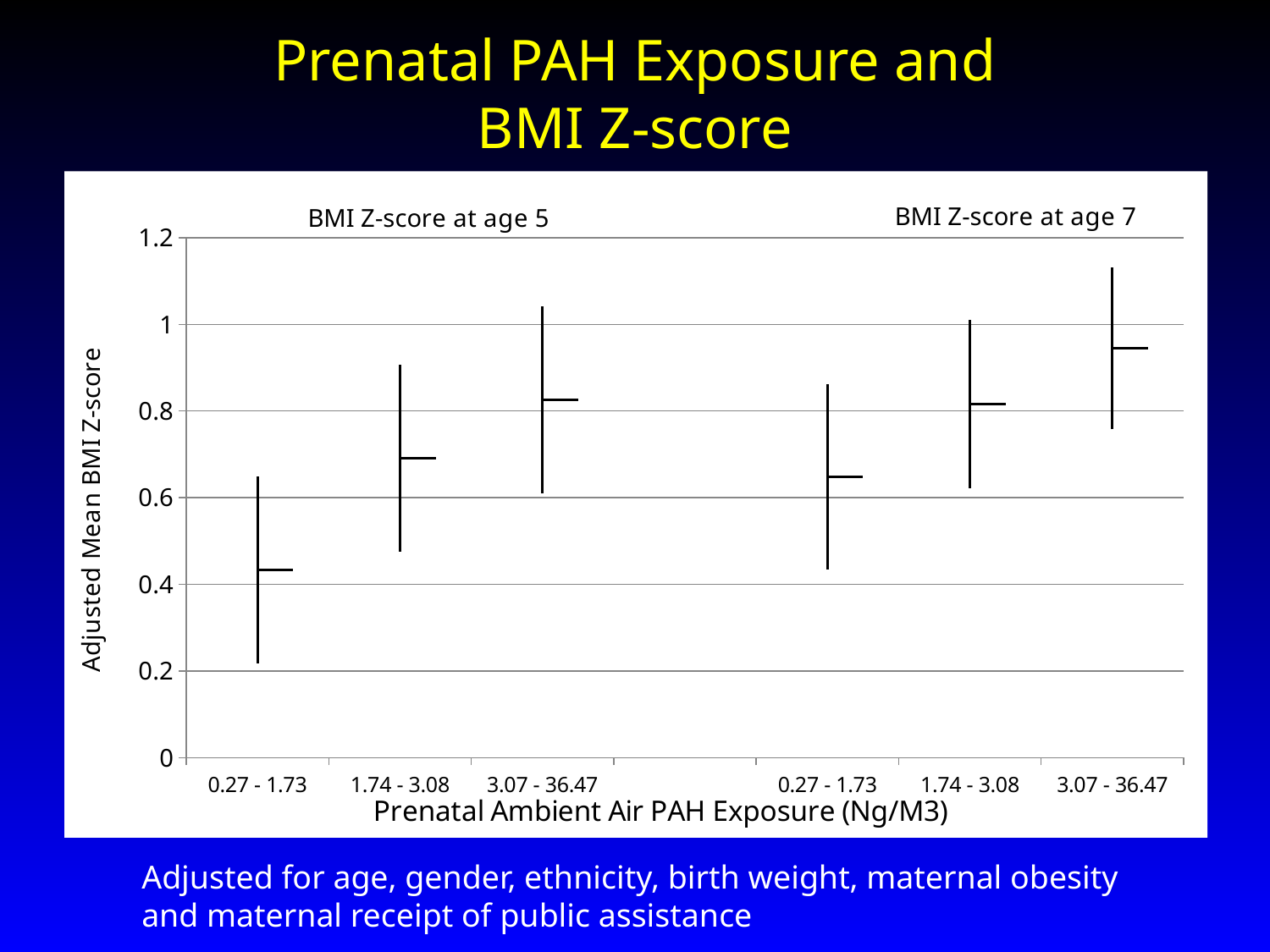
What is the label of the y axis? Adjusted Mean BMI Z-score Do the mean BMI Z-scores at age 5 rise or fall as the exposure category increases? rise Which exposure category has the lowest mean BMI Z-score at age 5? 0.27 - 1.73 How many exposure categories are plotted in the BMI Z-score at age 5 group? 3 In the BMI Z-score at age 7 group, is the mean value for the 3.07 - 36.47 exposure category greater or less than 0.8? greater In the BMI Z-score at age 5 group, is the mean value for the 0.27 - 1.73 exposure category greater or less than 0.6? less In the BMI Z-score at age 5 group, is the mean value for the 3.07 - 36.47 exposure category greater or less than 1? less How many groups (panels) of points does the chart show? 2 For the 0.27 - 1.73 exposure category, is the mean BMI Z-score higher at age 5 or at age 7? age 7 Which exposure category has the highest mean BMI Z-score at age 7? 3.07 - 36.47 What is the title of the chart? Prenatal PAH Exposure and BMI Z-score